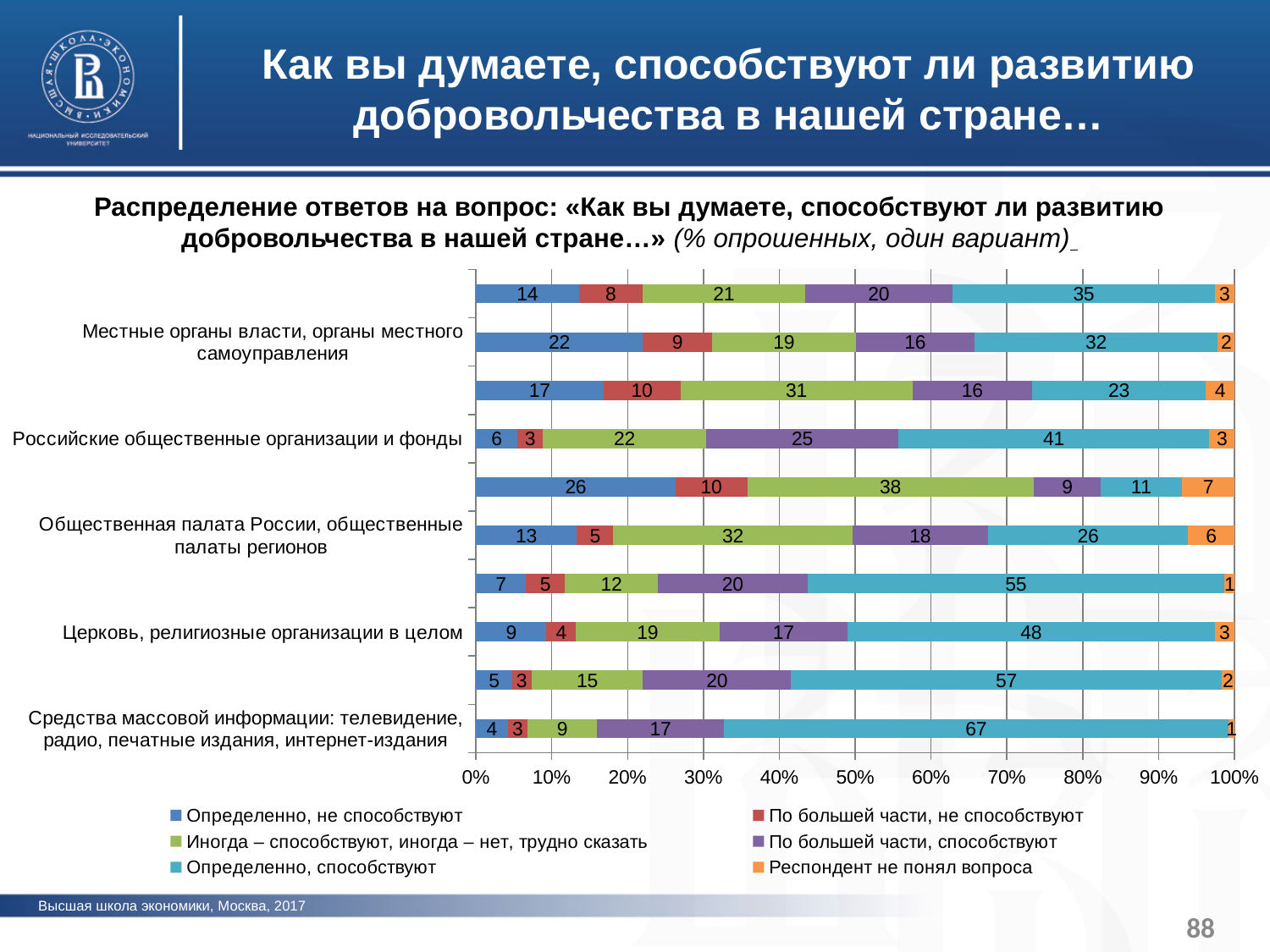
How many series does the legend list? 6 Among the labelled categories, which has the highest value for «Определенно, способствуют»? Средства массовой информации: телевидение, радио, печатные издания, интернет-издания What percentage of respondents answered «Определенно, способствуют» for «Средства массовой информации: телевидение, радио, печатные издания, интернет-издания»? 67 Among the labelled categories, which has the lowest value for «Определенно, не способствуют»? Средства массовой информации: телевидение, радио, печатные издания, интернет-издания What is the value of «По большей части, способствуют» for «Российские общественные организации и фонды»? 25 Which legend entry is shown in orange? Респондент не понял вопроса What is the value of «Иногда – способствуют, иногда – нет, трудно сказать» for «Местные органы власти, органы местного самоуправления»? 19 What is the value of «Респондент не понял вопроса» for «Общественная палата России, общественные палаты регионов»? 6 What is the value of «Определенно, не способствуют» for «Церковь, религиозные организации в целом»? 9 What is the difference between the «Определенно, способствуют» values for «Церковь, религиозные организации в целом» and «Общественная палата России, общественные палаты регионов»? 22 Which has the larger value for «Определенно, не способствуют»: «Местные органы власти, органы местного самоуправления» or «Церковь, религиозные организации в целом»? Местные органы власти, органы местного самоуправления What kind of chart is shown on the slide? Stacked bar chart